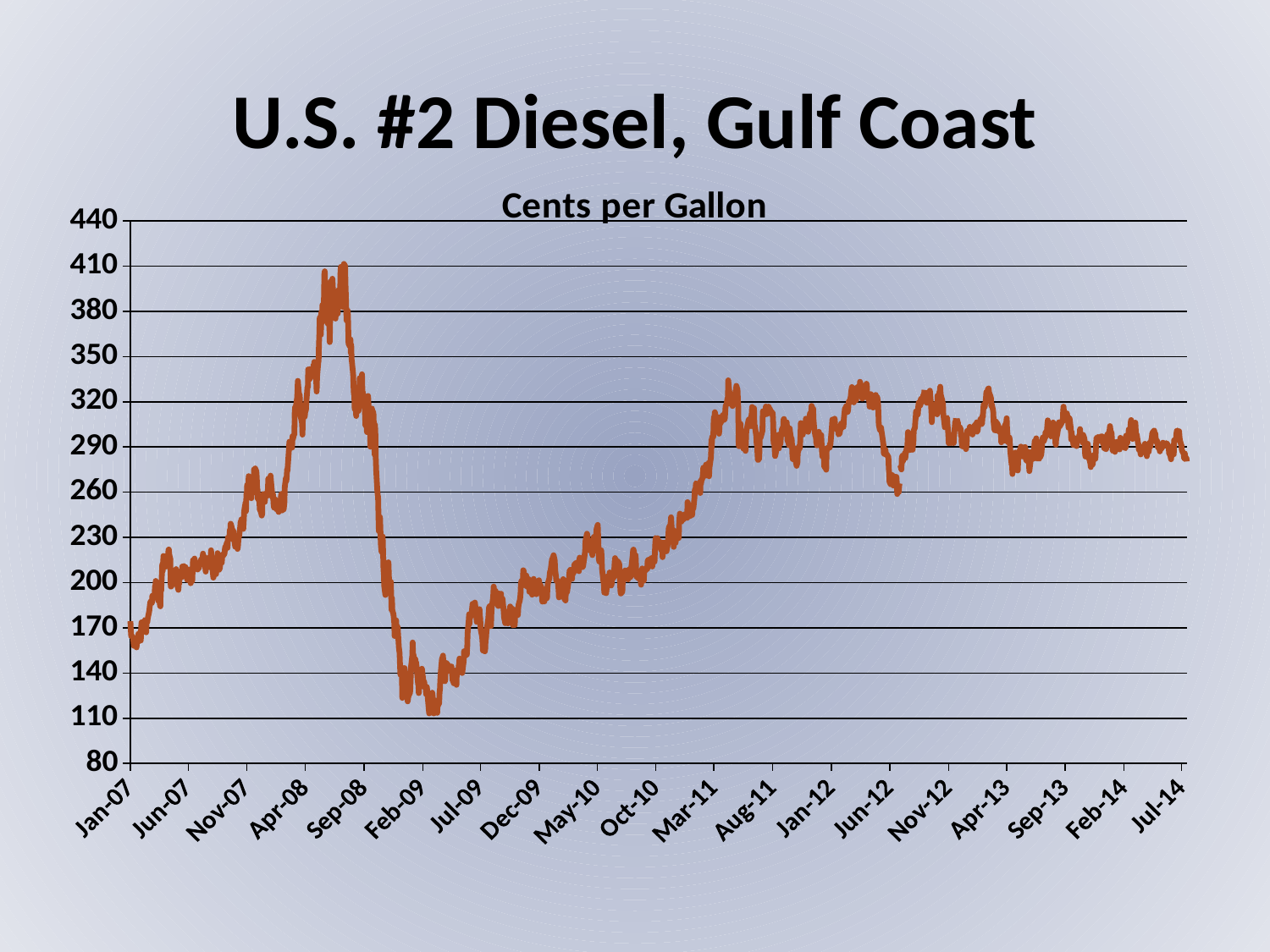
What is the title of the chart? Cents per Gallon How many month labels are shown along the x axis? 19 Is the lowest value reached around Feb-09 greater or less than 140? less How many data series are plotted on the chart? 1 Is the value at Jan-07 greater or less than 200? less Does the line rise or fall between Sep-08 and Feb-09? fall Near which labelled month does the line reach its lowest value? Feb-09 Is the value at Jul-14 greater or less than 260? greater In what units are the values on the chart expressed? Cents per Gallon What kind of chart is shown on the slide? Line chart Does the line rise or fall between Jan-07 and Sep-08? rise